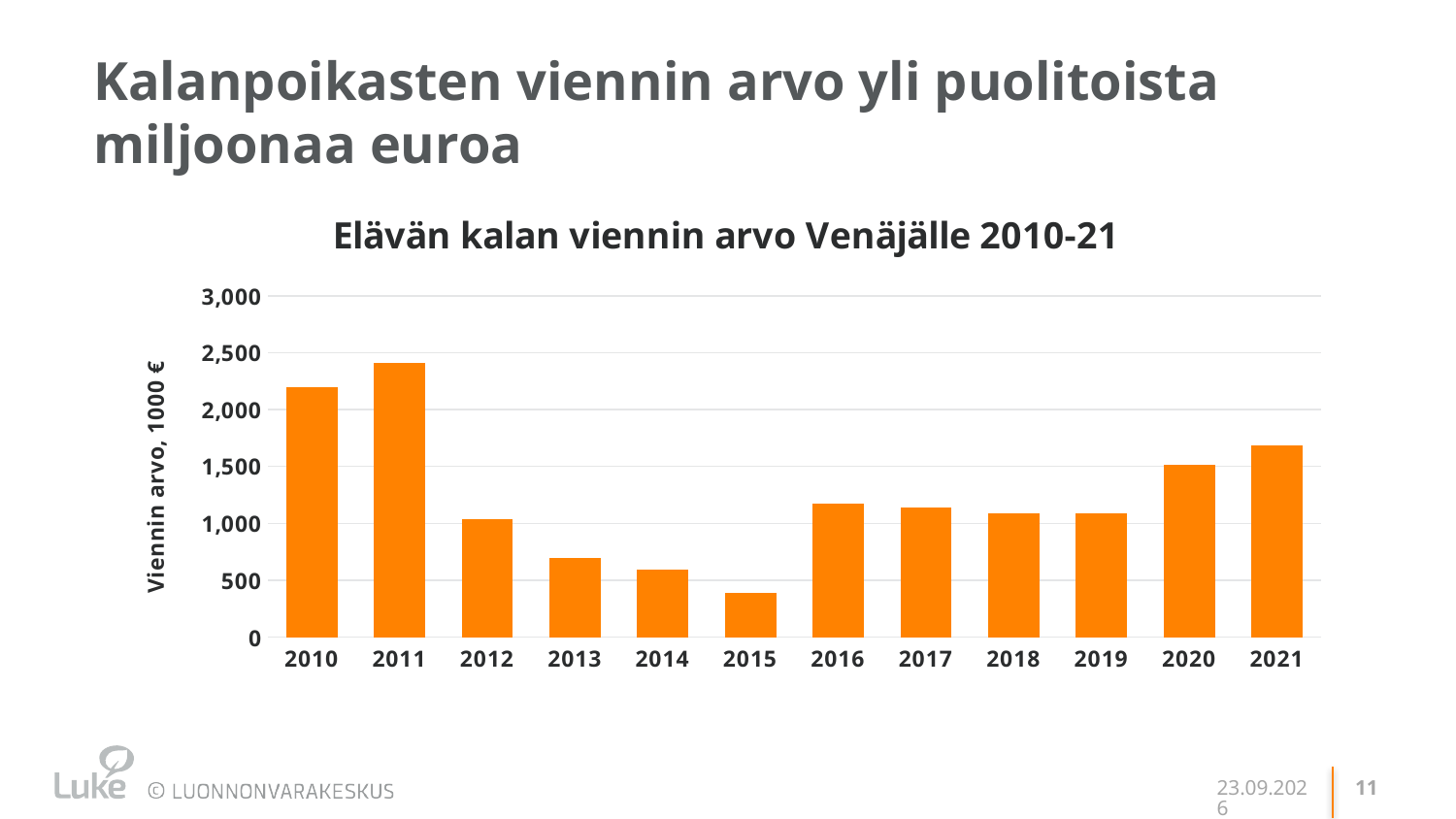
Which year has the larger value, 2020 or 2021? 2021 What is the label of the vertical axis? Viennin arvo, 1000 € Do the values rise or fall from 2011 to 2015? fall How many years (bars) are shown in the chart? 12 Which year has the highest export value in the chart? 2011 Is the value for 2015 greater or less than 500? less Is the value for 2010 greater or less than 2,000? greater What kind of chart is shown on the slide? bar chart Is the value for 2021 greater or less than 1,500? greater Which year has the lowest export value in the chart? 2015 Which year has the larger value, 2010 or 2012? 2010